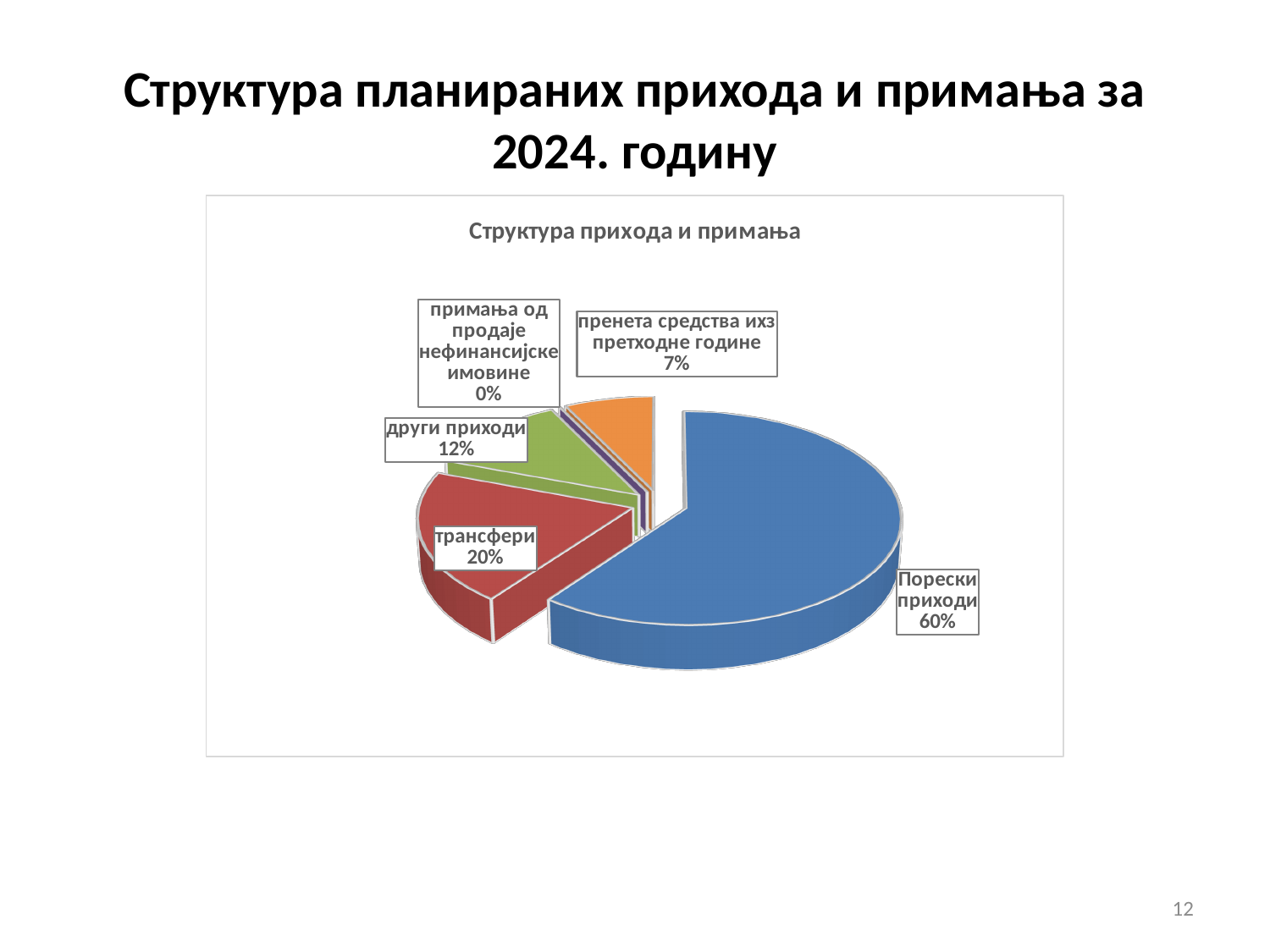
What share of the pie is Порески приходи? 60% Which category has the largest share of the pie? Порески приходи What is the title of the chart? Структура прихода и примања Which is larger, the share for други приходи or the share for пренета средства из претходне године? други приходи What kind of chart is shown on the slide? pie chart What share of the pie is примања од продаје нефинансијске имовине? 0% What share of the pie is трансфери? 20% What is the difference in percentage points between Порески приходи and трансфери? 40 What share of the pie is други приходи? 12% What colour is the slice for Порески приходи? blue What share of the pie is пренета средства из претходне године? 7%